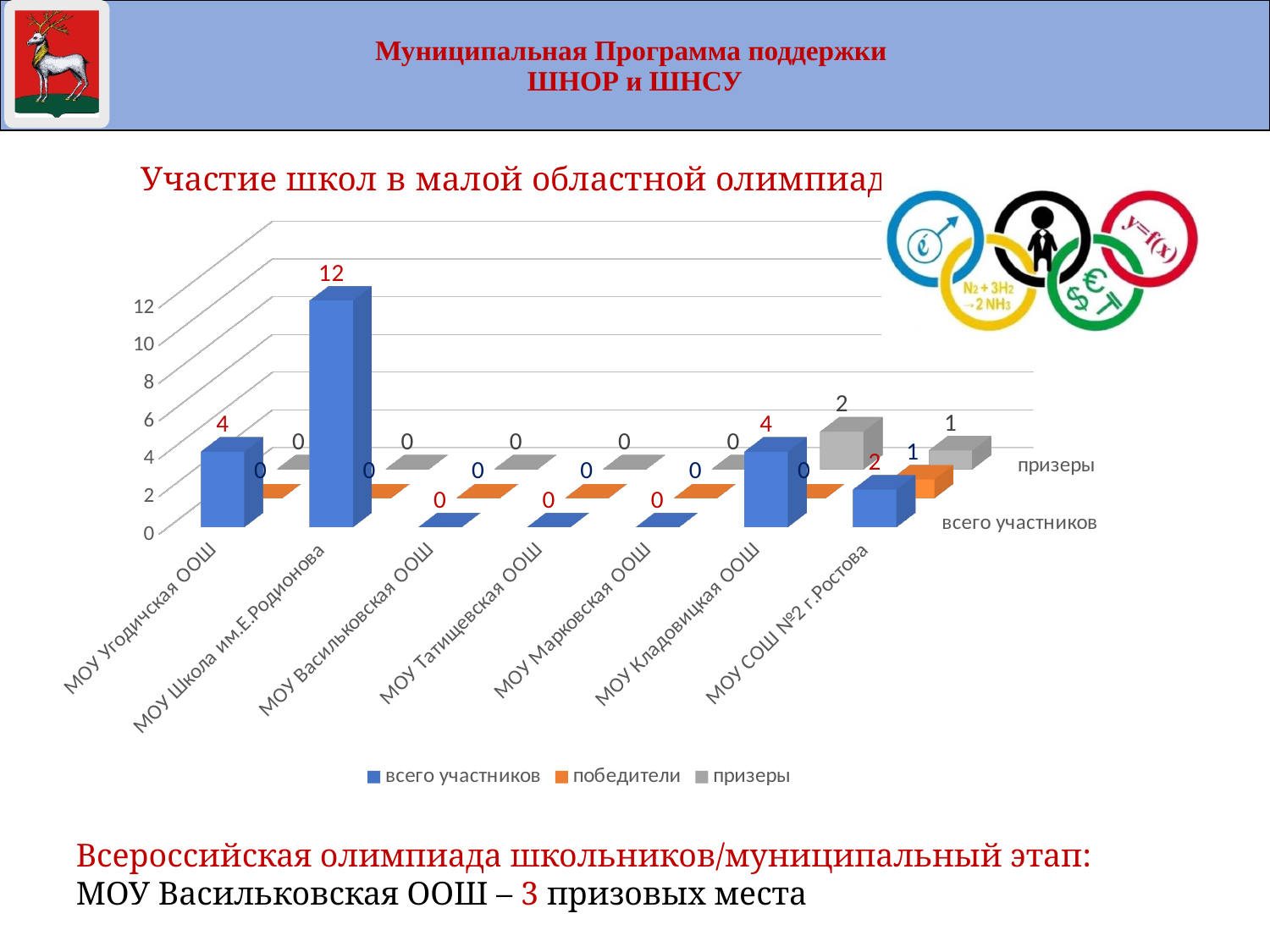
How many schools (categories) are shown on the x axis of the chart? 7 What is the value of 'победители' for МОУ СОШ №2 г.Ростова? 1 Which series in the legend is shown in orange? победители What is the value of 'всего участников' for МОУ Школа им.Е.Родионова? 12 How many series does the chart legend list? 3 What is the value of 'всего участников' for МОУ Угодичская ООШ? 4 What kind of chart is shown on the slide? bar chart What is the value of 'призеры' for МОУ Кладовицкая ООШ? 2 What is the difference between 'всего участников' for МОУ Школа им.Е.Родионова and МОУ Кладовицкая ООШ? 8 Which is larger: 'всего участников' for МОУ Кладовицкая ООШ or for МОУ СОШ №2 г.Ростова? МОУ Кладовицкая ООШ Which school has the highest value for 'всего участников'? МОУ Школа им.Е.Родионова What is the value of 'всего участников' for МОУ Васильковская ООШ? 0